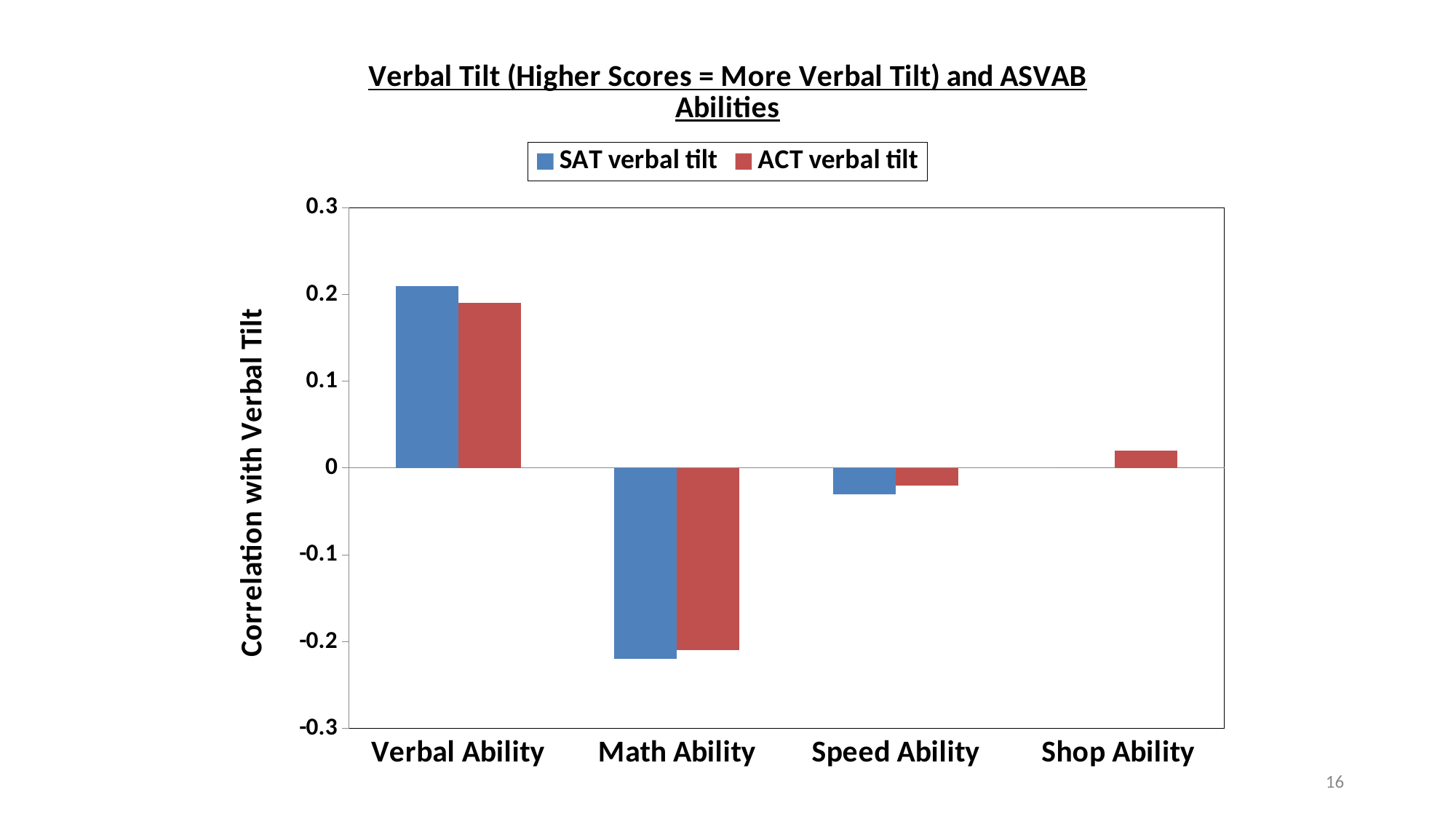
Which category has the highest SAT verbal tilt correlation? Verbal Ability Is the ACT verbal tilt correlation for Math Ability greater or less than -0.1? less Is the SAT verbal tilt correlation for Verbal Ability greater or less than 0.1? greater Is the SAT verbal tilt correlation for Speed Ability greater or less than 0? less For Verbal Ability, which series has the larger correlation, SAT verbal tilt or ACT verbal tilt? SAT verbal tilt What colour represents the ACT verbal tilt series? red What is the label of the y axis? Correlation with Verbal Tilt Which category has the lowest SAT verbal tilt correlation? Math Ability Which category has the lowest ACT verbal tilt correlation? Math Ability What kind of chart is shown on the slide? bar chart How many ability categories are shown on the x axis? 4 How many series does the legend list? 2